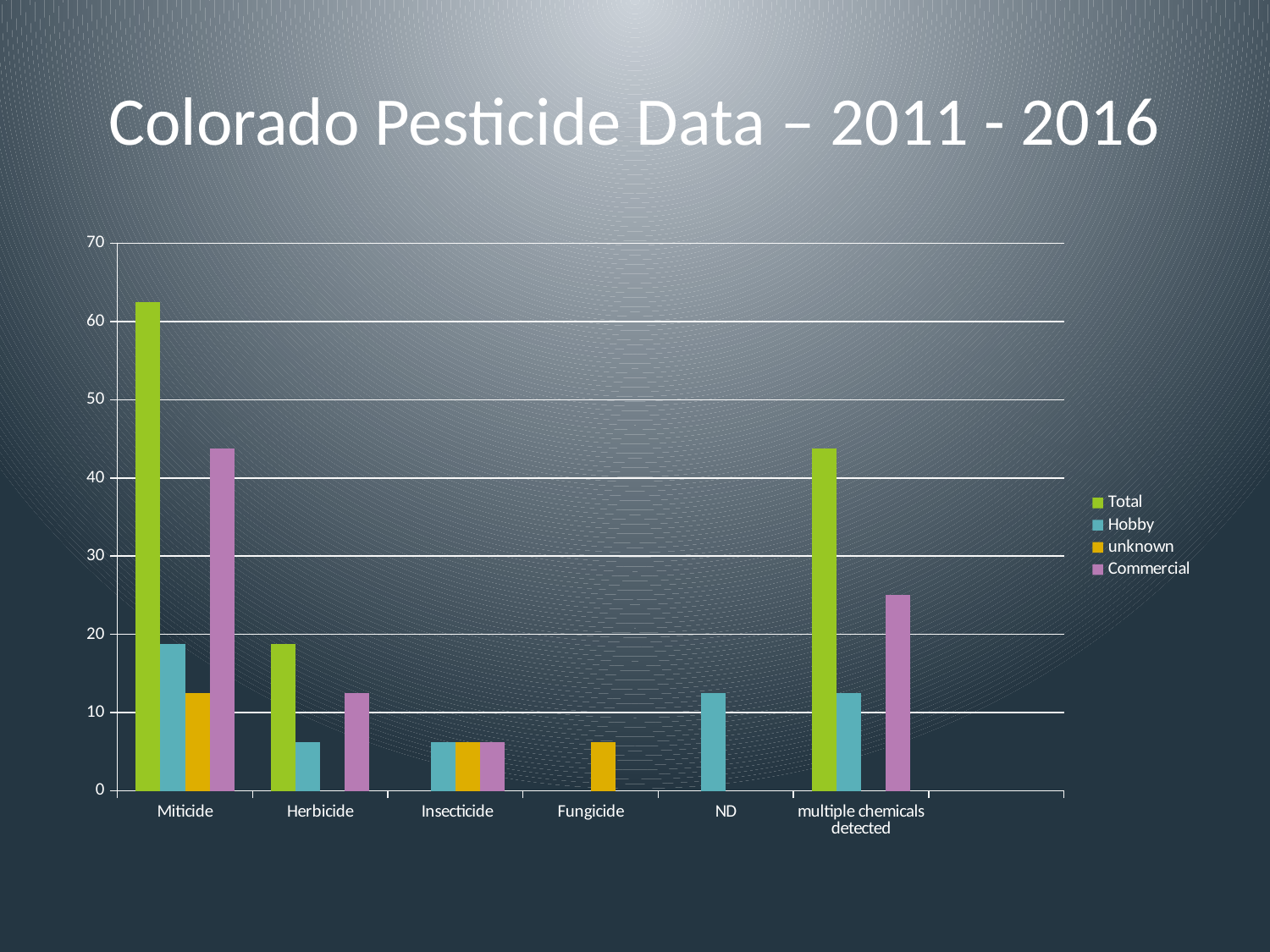
How many series does the legend list? 4 Which is larger, the Total value for Miticide or the Total value for multiple chemicals detected? Miticide How many categories are shown on the x axis? 6 What is the title of the slide? Colorado Pesticide Data – 2011 - 2016 Which is larger, the Hobby value for Miticide or the Hobby value for Herbicide? Miticide Is the Commercial value for Miticide greater or less than 40? greater Is the Commercial value for multiple chemicals detected greater or less than 30? less Which category has the highest Total value? Miticide Which series is shown in green in the legend? Total Is the Total value for Herbicide greater or less than 20? less What kind of chart is shown on the slide? bar chart